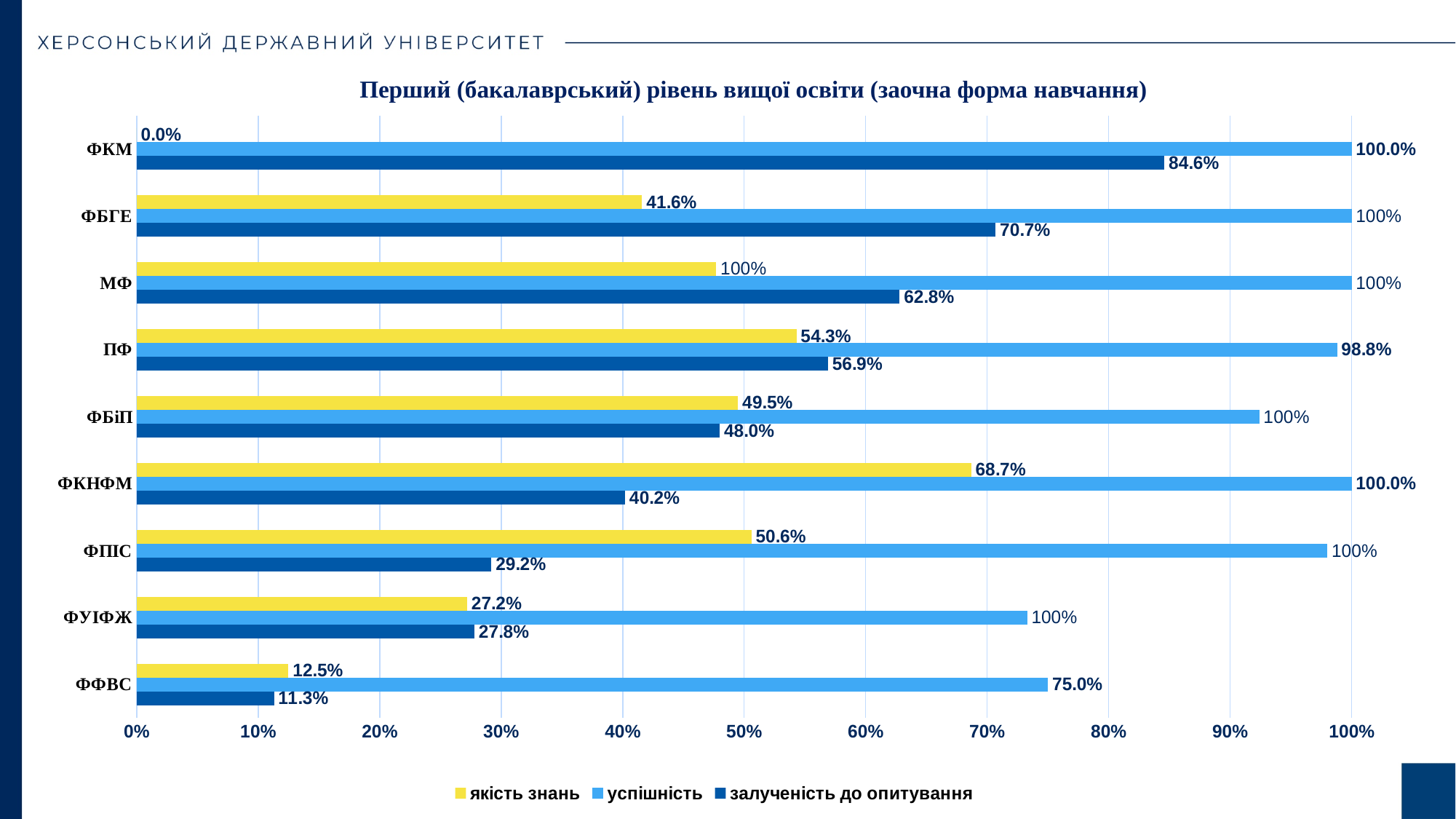
Which faculty has the lowest value of залученість до опитування? ФФВС What is the difference between залученість до опитування for ФБГЕ and for ФКНФМ? 30.5 percentage points How many faculties (categories) are shown on the y axis? 9 Is the value of залученість до опитування for ФКНФМ greater or less than 50%? less What is the value of залученість до опитування for ФКМ? 84.6% Which faculty has the highest value of залученість до опитування? ФКМ What colour represents the series якість знань in the legend? yellow How many series does the legend list? 3 What kind of chart is shown on the slide? bar chart What is the value of успішність for ФФВС? 75.0% Which is larger: якість знань for ПФ or якість знань for ФПІС? ПФ What is the value of якість знань for ФКНФМ? 68.7%